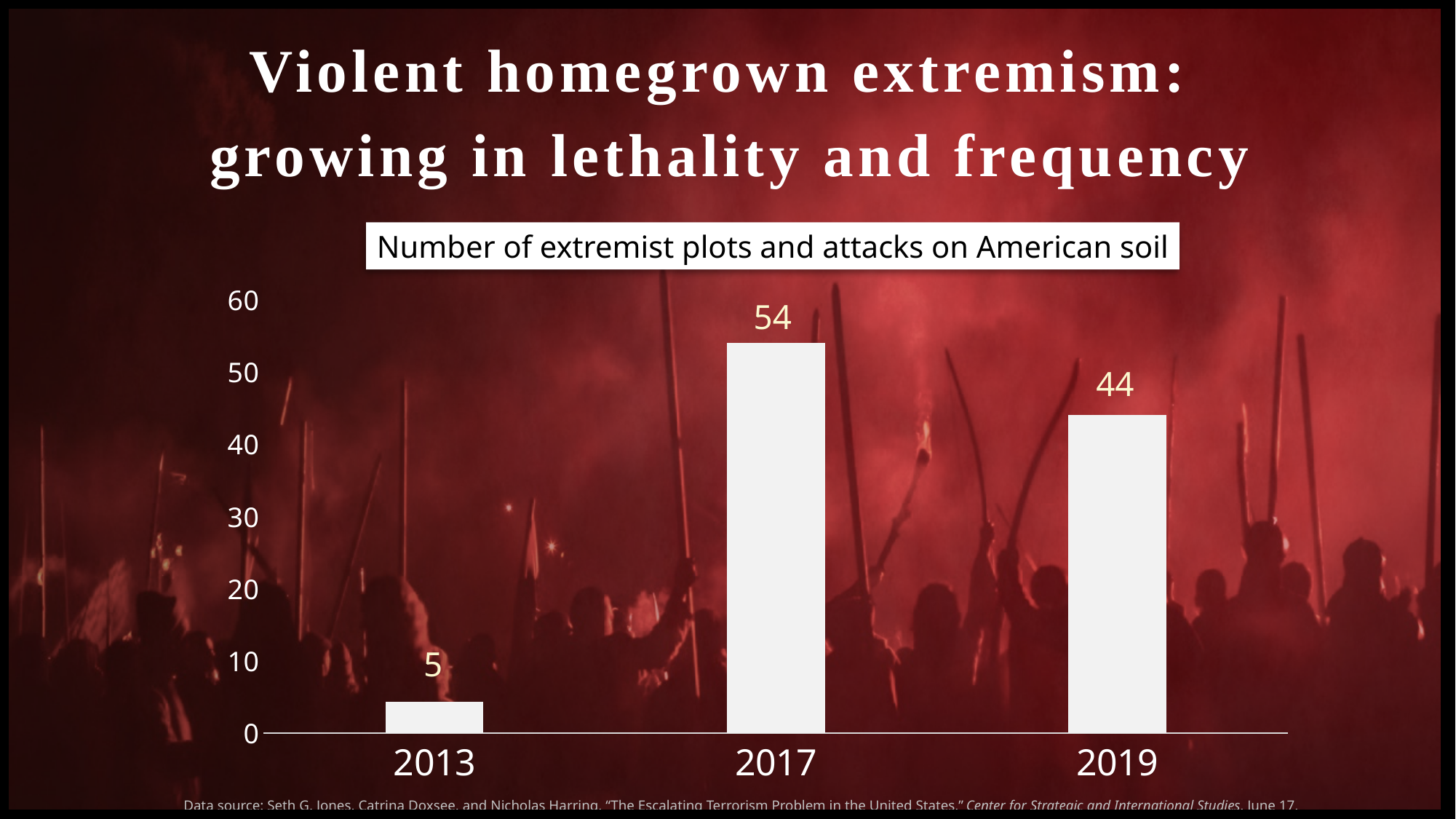
What kind of chart is shown on the slide? Bar chart Which year has the highest number of extremist plots and attacks? 2017 Which year has a larger value, 2013 or 2019? 2019 Is the value for 2019 greater or less than 40? greater What is the number of extremist plots and attacks for 2019? 44 What is the difference between the values for 2017 and 2019? 10 What is the title of the chart? Number of extremist plots and attacks on American soil What is the number of extremist plots and attacks for 2017? 54 Which year has the lowest number of extremist plots and attacks? 2013 How many years are shown on the chart? 3 What is the difference between the values for 2017 and 2013? 49 What is the number of extremist plots and attacks for 2013? 5